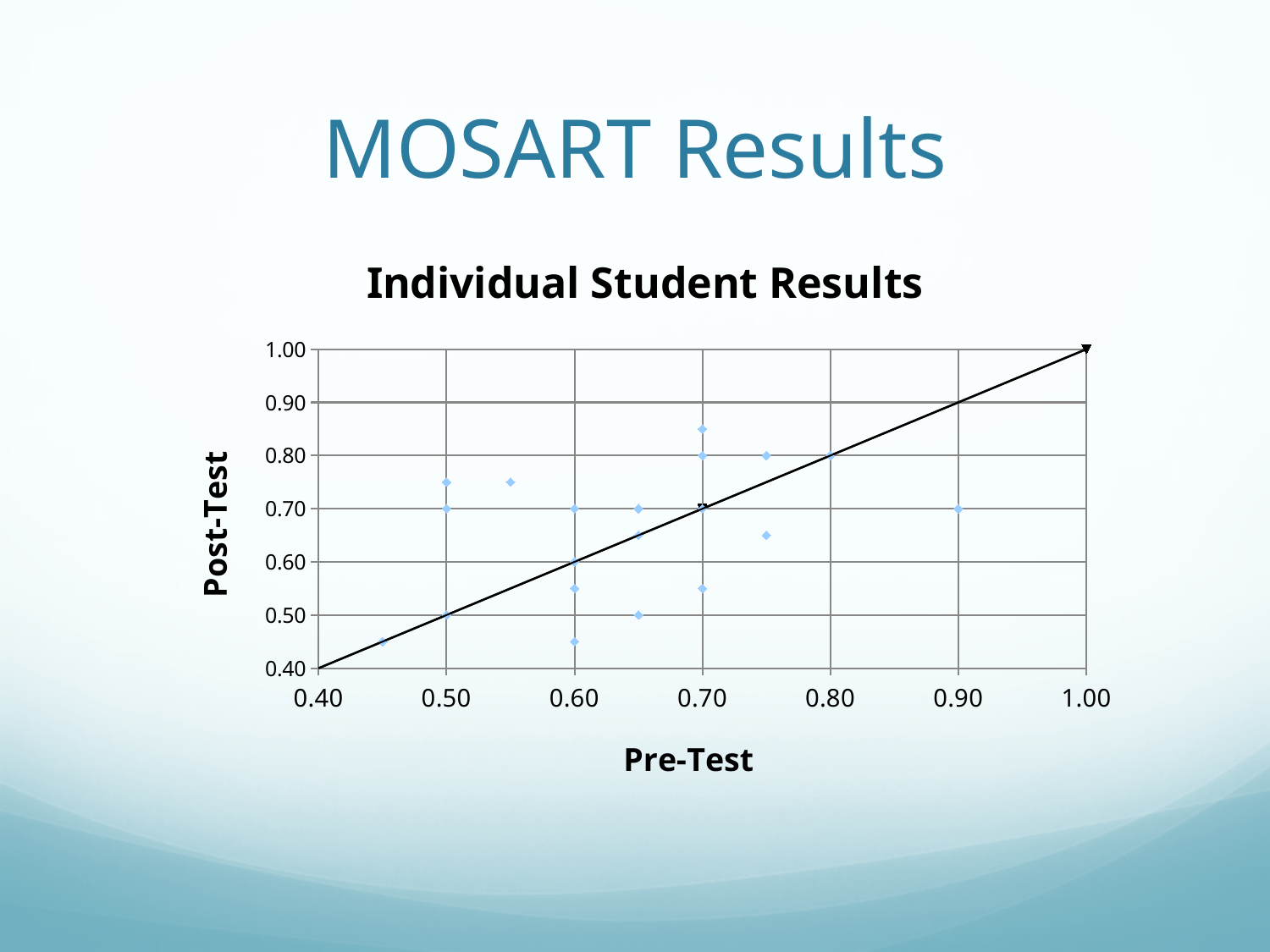
Is the Post-Test value of the student with a Pre-Test score of 0.90 greater or less than 0.80? less Is the lowest Post-Test value on the chart greater or less than 0.50? less Which has the higher Post-Test value: the highest point at Pre-Test 0.70 or the point at Pre-Test 0.90? The highest point at Pre-Test 0.70 What is the label of the horizontal axis of the chart? Pre-Test What is the lowest Post-Test value among the points with a Pre-Test value of 0.50? 0.50 Is the highest Post-Test value on the chart greater or less than 0.80? greater What is the highest Pre-Test value plotted on the chart? 0.90 What is the Post-Test value of the student with the highest Pre-Test score (0.90)? 0.70 What kind of chart is shown on the slide? Scatter chart What is the title of the chart? Individual Student Results What is the highest Post-Test value among the points with a Pre-Test value of 0.75? 0.80